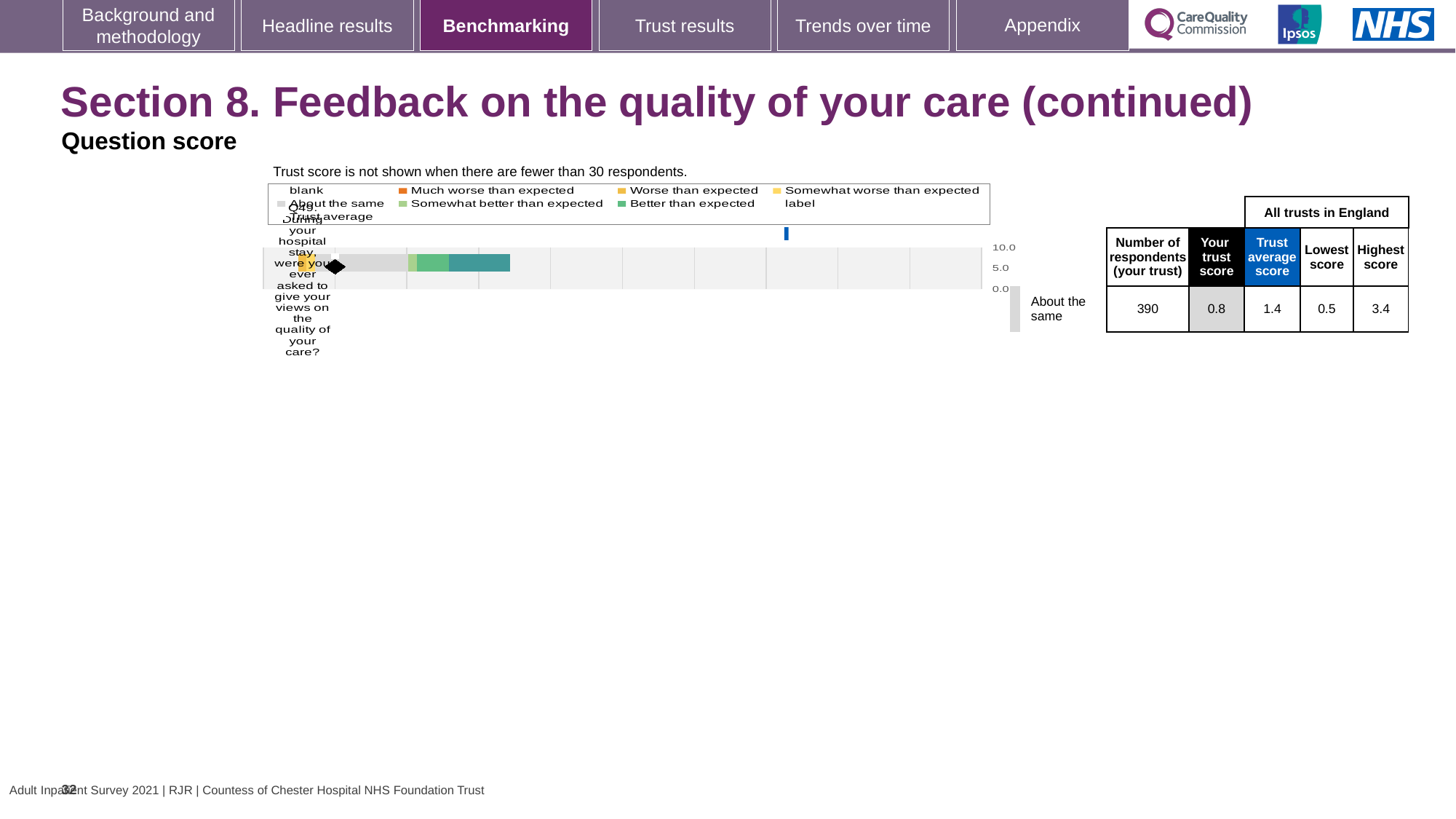
According to the table beside the chart, what is the lowest score among all trusts in England? 0.5 According to the table beside the chart, what is your trust score for Q49? 0.8 What is the highest tick value shown on the chart's numeric axis? 10.0 According to the table beside the chart, what is the number of respondents for your trust? 390 What colour does the legend use for 'Much worse than expected'? orange Which is larger for Q49: your trust score or the trust average score? trust average score According to the table beside the chart, what is the trust average score for Q49? 1.4 Which question number is plotted on the chart? Q49 What is the difference between the highest score and the lowest score for Q49 in the table? 2.9 What kind of chart is shown on the slide? bar chart What benchmark category label is shown next to the chart for Q49? About the same According to the table beside the chart, what is the highest score among all trusts in England? 3.4